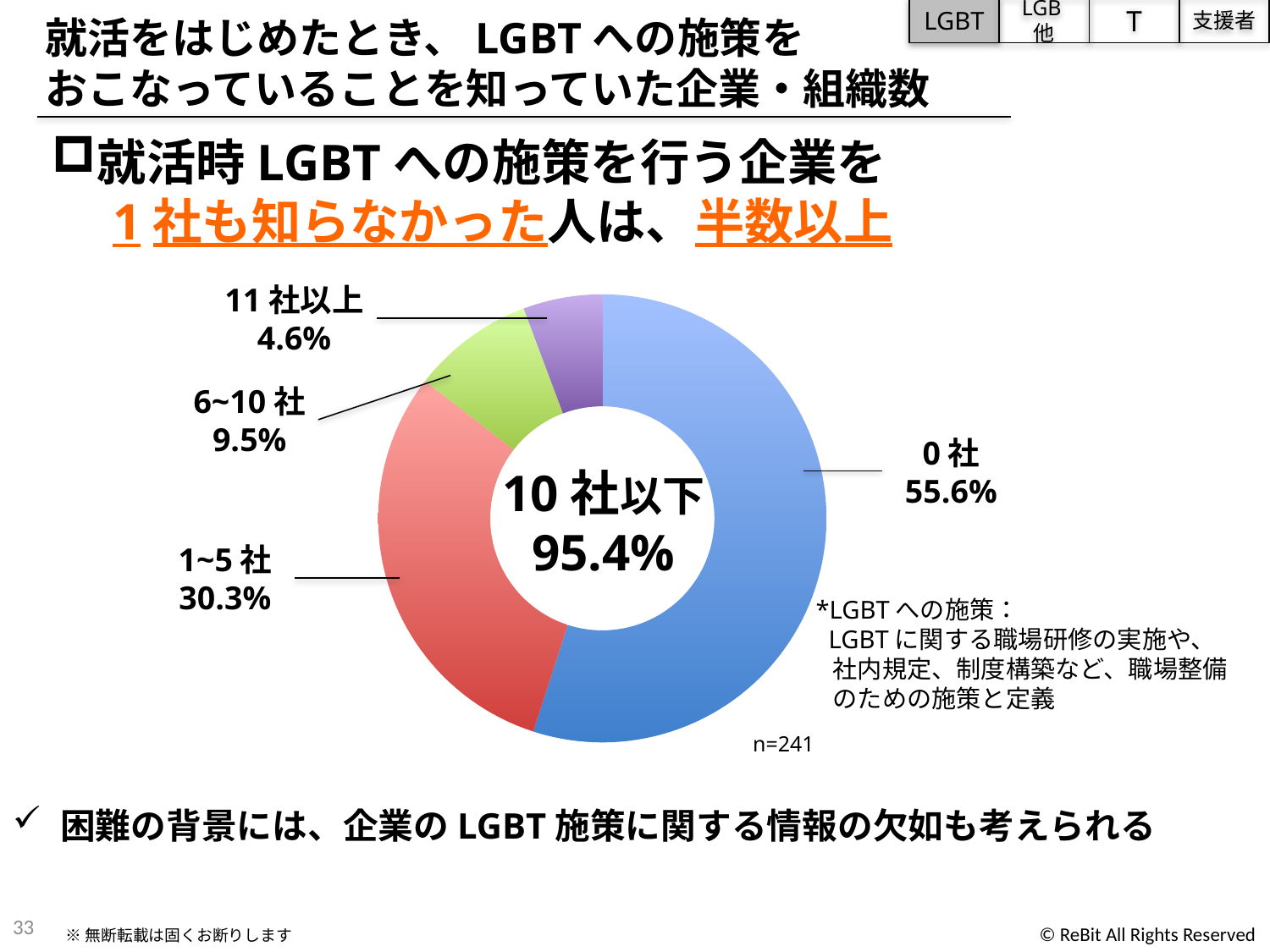
What percentage is shown for the 6~10社 slice? 9.5% How many slices does the pie chart have? 4 What is the difference in percentage points between the 0社 slice and the 1~5社 slice? 25.3 What sample size (n) is shown next to the chart? n=241 Which category has the smallest share of the pie? 11社以上 What kind of chart is shown on the slide? Pie chart (donut) Which slice is larger, 6~10社 or 11社以上? 6~10社 What combined percentage is printed in the centre of the donut for 10社以下? 95.4% What percentage is shown for the 1~5社 slice? 30.3% What percentage is shown for the 0社 slice? 55.6% Which category has the largest share of the pie? 0社 What percentage is shown for the 11社以上 slice? 4.6%